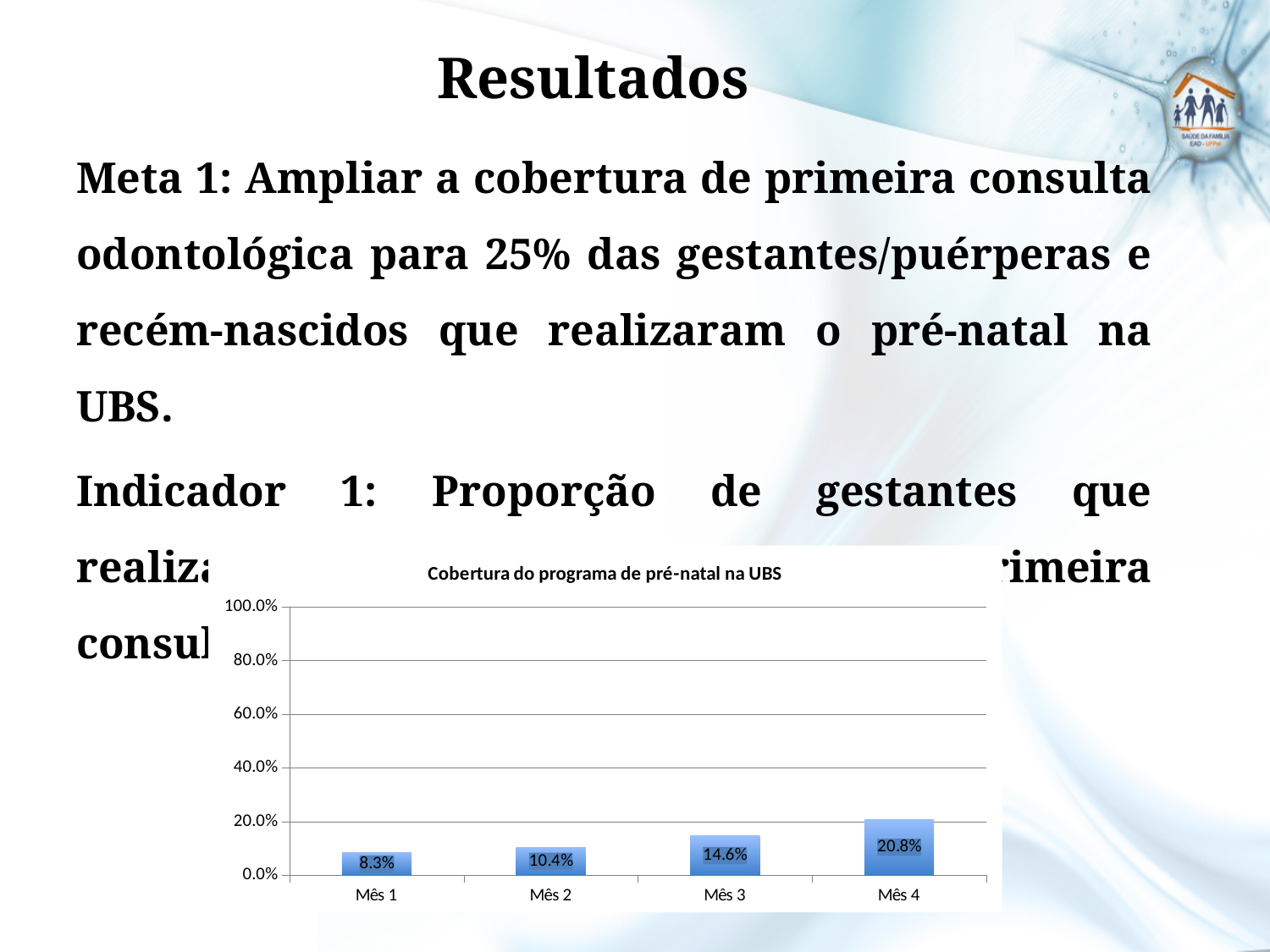
What is the difference between the values for Mês 3 and Mês 2? 4.2% Is the value for Mês 4 greater or less than 40.0%? less What kind of chart is shown? bar chart Do the values rise or fall from Mês 1 to Mês 4? rise What is the value for Mês 3? 14.6% Which is larger, the value for Mês 2 or the value for Mês 3? Mês 3 What is the difference between the values for Mês 4 and Mês 1? 12.5% What is the value for Mês 4? 20.8% Which month has the highest value? Mês 4 What is the value for Mês 1? 8.3% Which month has the lowest value? Mês 1 How many months are shown on the x axis? 4